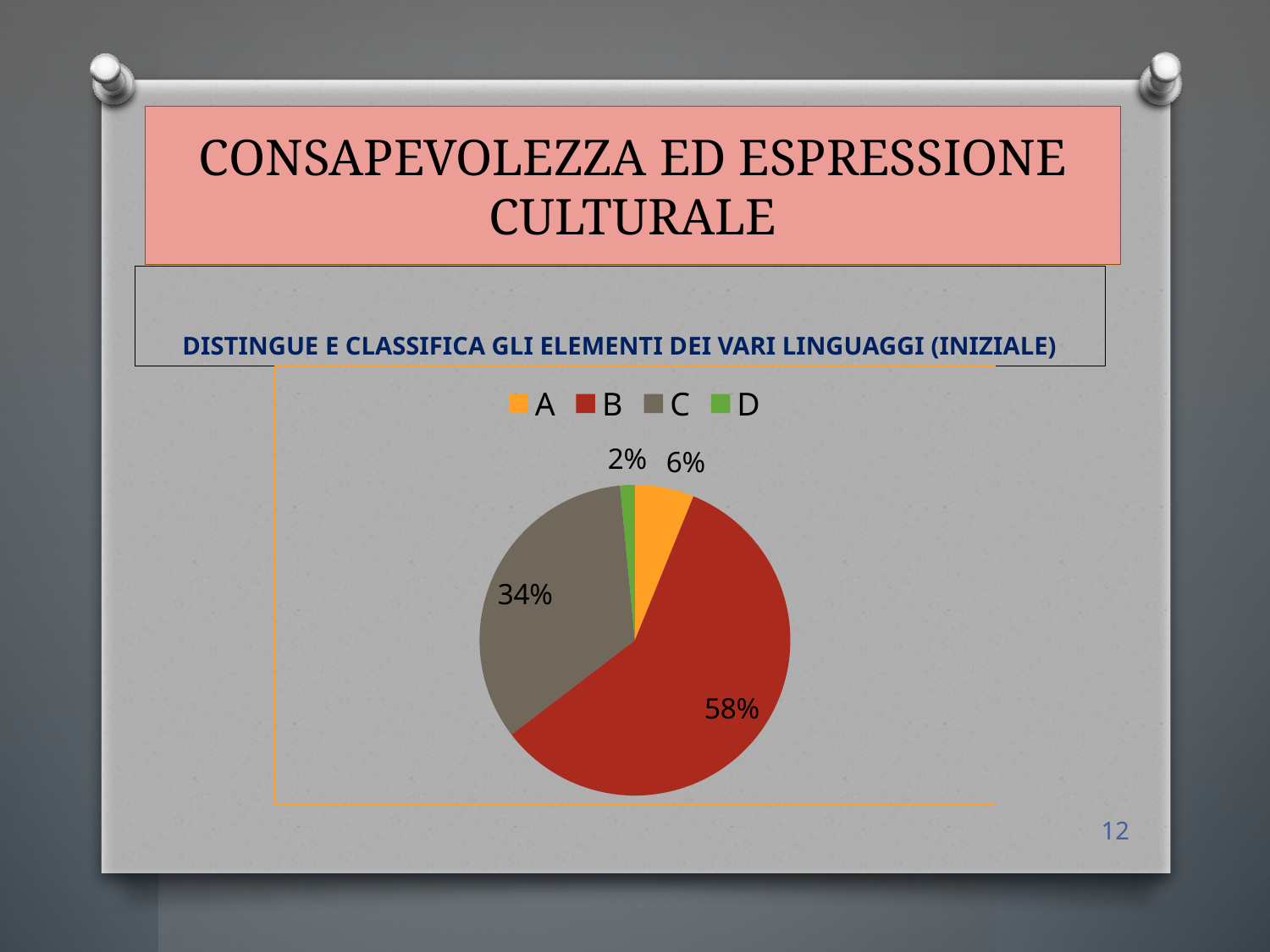
Which category has the largest share of the pie? B What type of chart is shown on the slide? pie chart What percentage of the pie does category C represent? 34% Which category has the smallest share of the pie? D What percentage of the pie does category A represent? 6% How many categories does the legend list? 4 What is the difference in percentage points between category B and category C? 24 What colour is the slice for category C? grey Which category has a larger share, A or C? C How many slices does the pie chart have? 4 What percentage of the pie does category B represent? 58% What percentage of the pie does category D represent? 2%